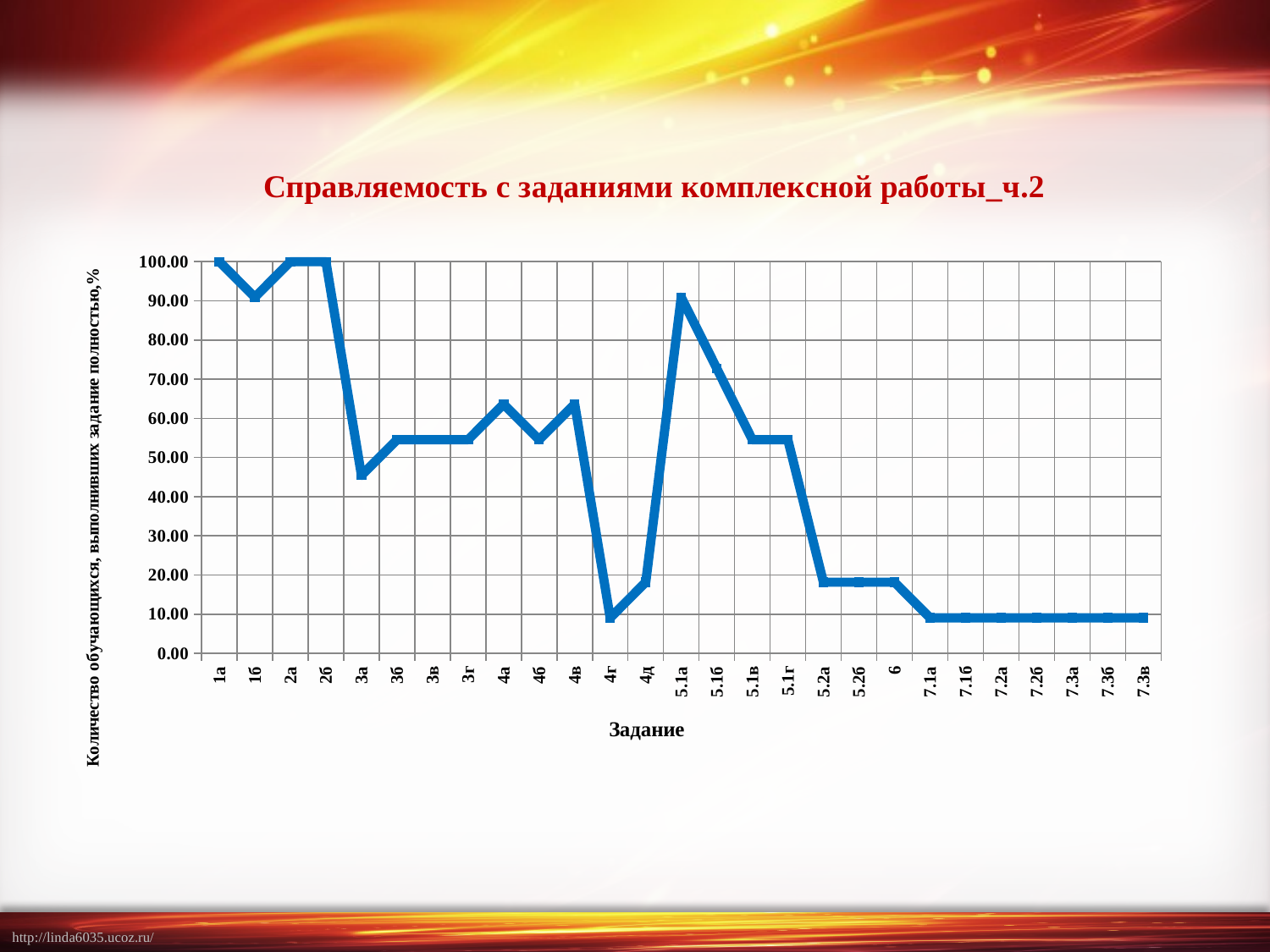
Overall, do the values rise or fall from left to right along the x axis? fall What type of chart is shown on the slide? line chart What is the title of the chart? Справляемость с заданиями комплексной работы_ч.2 Is the value for task 4а greater or less than 60.00? greater Is the value for task 3а greater or less than 50.00? less What is the value for task 2б? 100.00 Which has a larger value, task 5.1а or task 5.1б? 5.1а What is the value for task 1а? 100.00 Is the value for task 5.1в greater or less than 50.00? greater Which has a larger value, task 3а or task 4а? 4а How many tasks (categories) are plotted on the x axis? 27